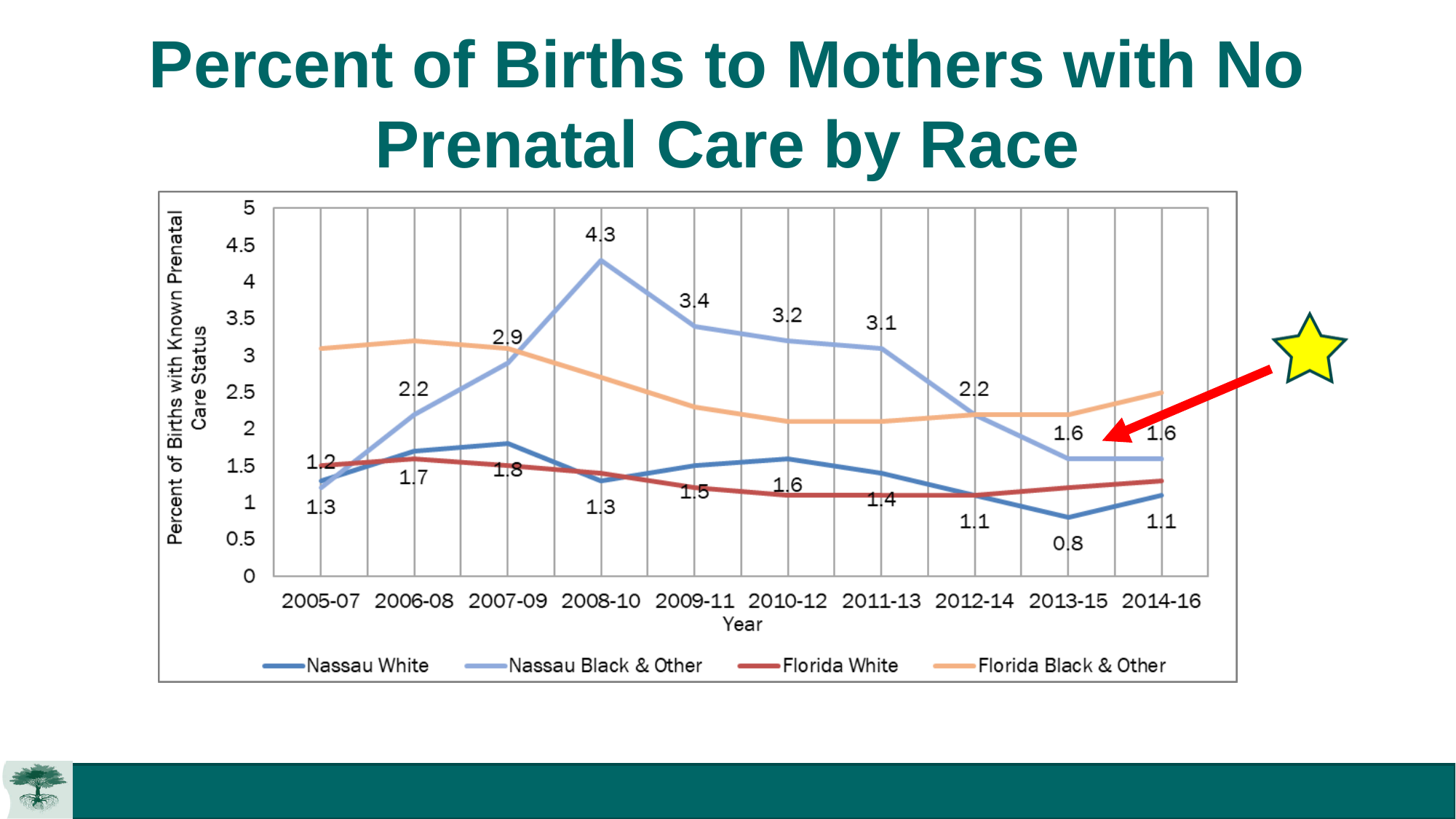
How many year periods are shown on the x axis? 10 What is the value for Nassau White in 2007-09? 1.8 How many series does the legend list? 4 In which year period is the Nassau Black & Other value highest? 2008-10 What is the label on the y axis? Percent of Births with Known Prenatal Care Status In which year period is the Nassau White value lowest? 2013-15 In 2010-12, which is larger: Nassau White or Nassau Black & Other? Nassau Black & Other What is the difference between the Nassau Black & Other values in 2008-10 and 2013-15? 2.7 What is the value for Nassau Black & Other in 2008-10? 4.3 What kind of chart is shown on the slide? line chart Does the Nassau Black & Other line rise or fall from 2008-10 to 2013-15? fall Is the value for Florida White in 2010-12 greater or less than 1.5? less